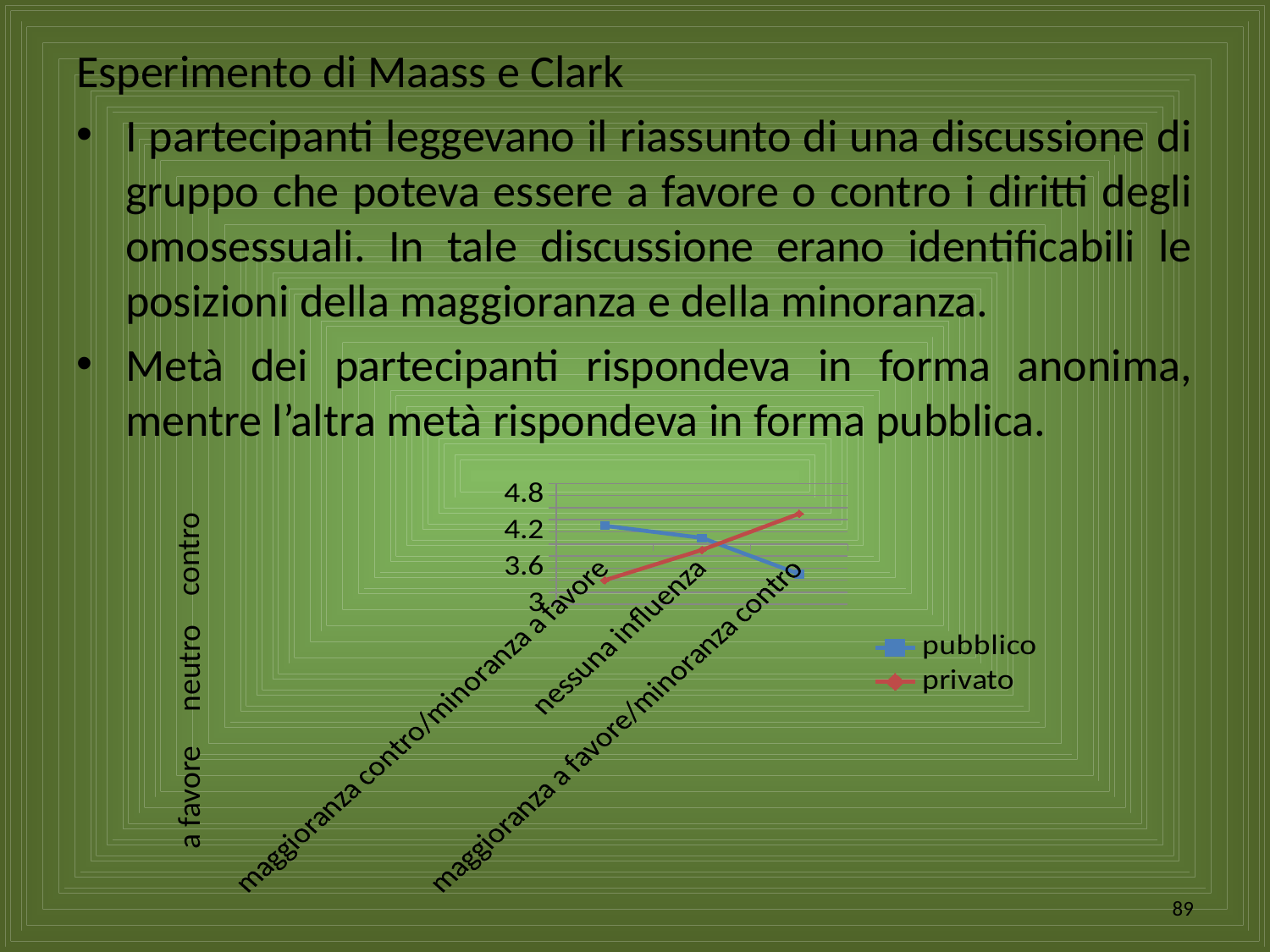
For which category is the 'privato' series lowest? maggioranza contro/minoranza a favore Do the values of the 'privato' series rise or fall from left to right along the x axis? rise For which category is the 'privato' series highest? maggioranza a favore/minoranza contro What kind of chart is shown on the slide? line chart For which category is the 'pubblico' series highest? maggioranza contro/minoranza a favore Is the value for 'privato' at 'maggioranza a favore/minoranza contro' greater or less than 4.2? greater How many categories are shown on the x axis of the chart? 3 At 'maggioranza a favore/minoranza contro', which series has the larger value, pubblico or privato? privato How many series does the chart legend list? 2 At 'maggioranza contro/minoranza a favore', which series has the larger value, pubblico or privato? pubblico Which series are listed in the chart legend? pubblico and privato Do the values of the 'pubblico' series rise or fall from left to right along the x axis? fall